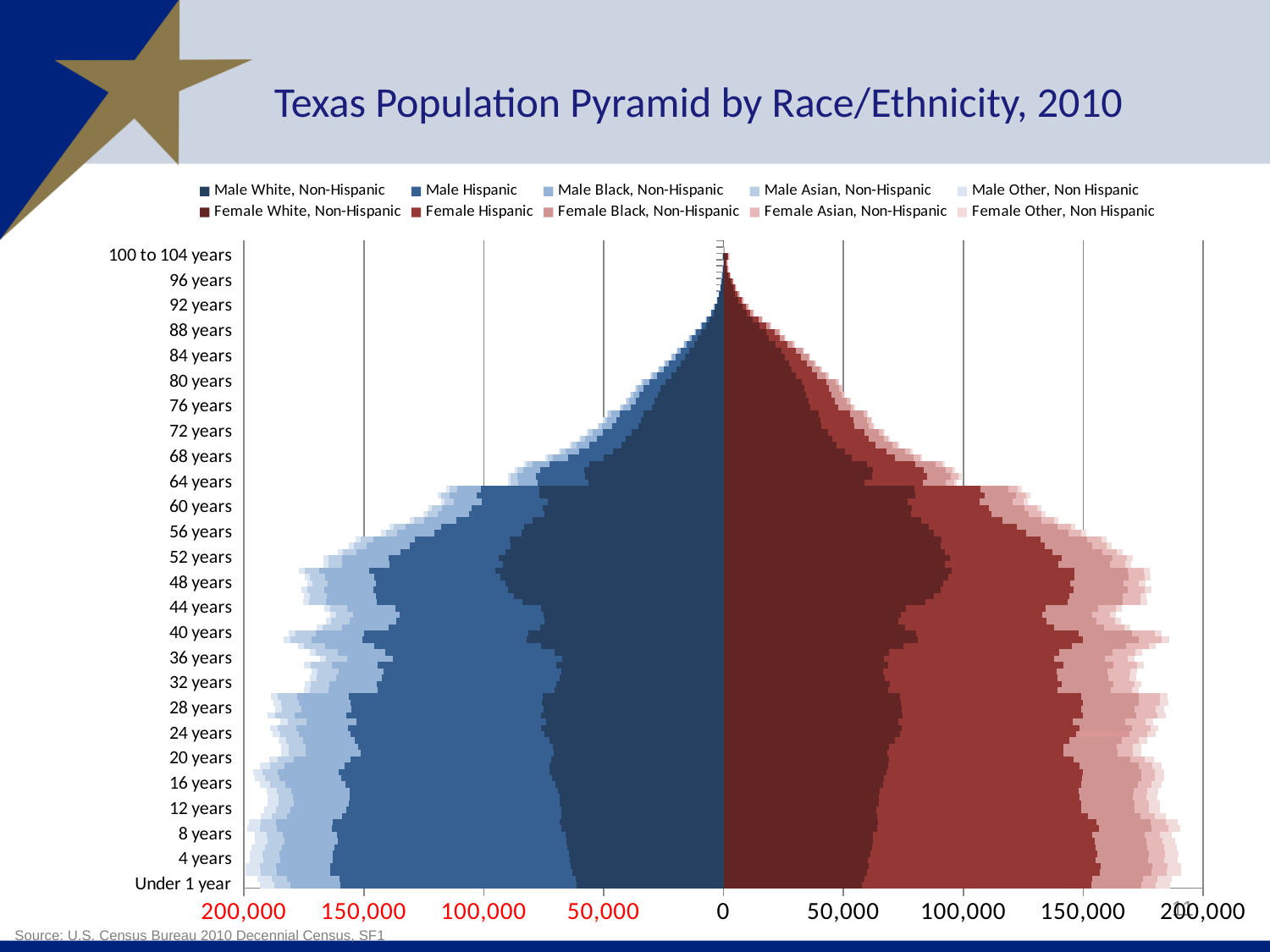
Is the total male population for the 64 years age group greater or less than 100,000? less Which age group has a larger total male population, Under 1 year or 88 years? Under 1 year Is the total female population for the 40 years age group greater or less than 150,000? greater What kind of chart is shown on the slide? Bar chart (population pyramid) How many series does the legend list? 10 Is the total female population for the 100 to 104 years age group greater or less than 50,000? less What is the title of the chart? Texas Population Pyramid by Race/Ethnicity, 2010 Moving from the 64 years age group up to the 100 to 104 years age group, do the total bar lengths rise or fall? fall Which colour family is used for the male series in the chart? Blue